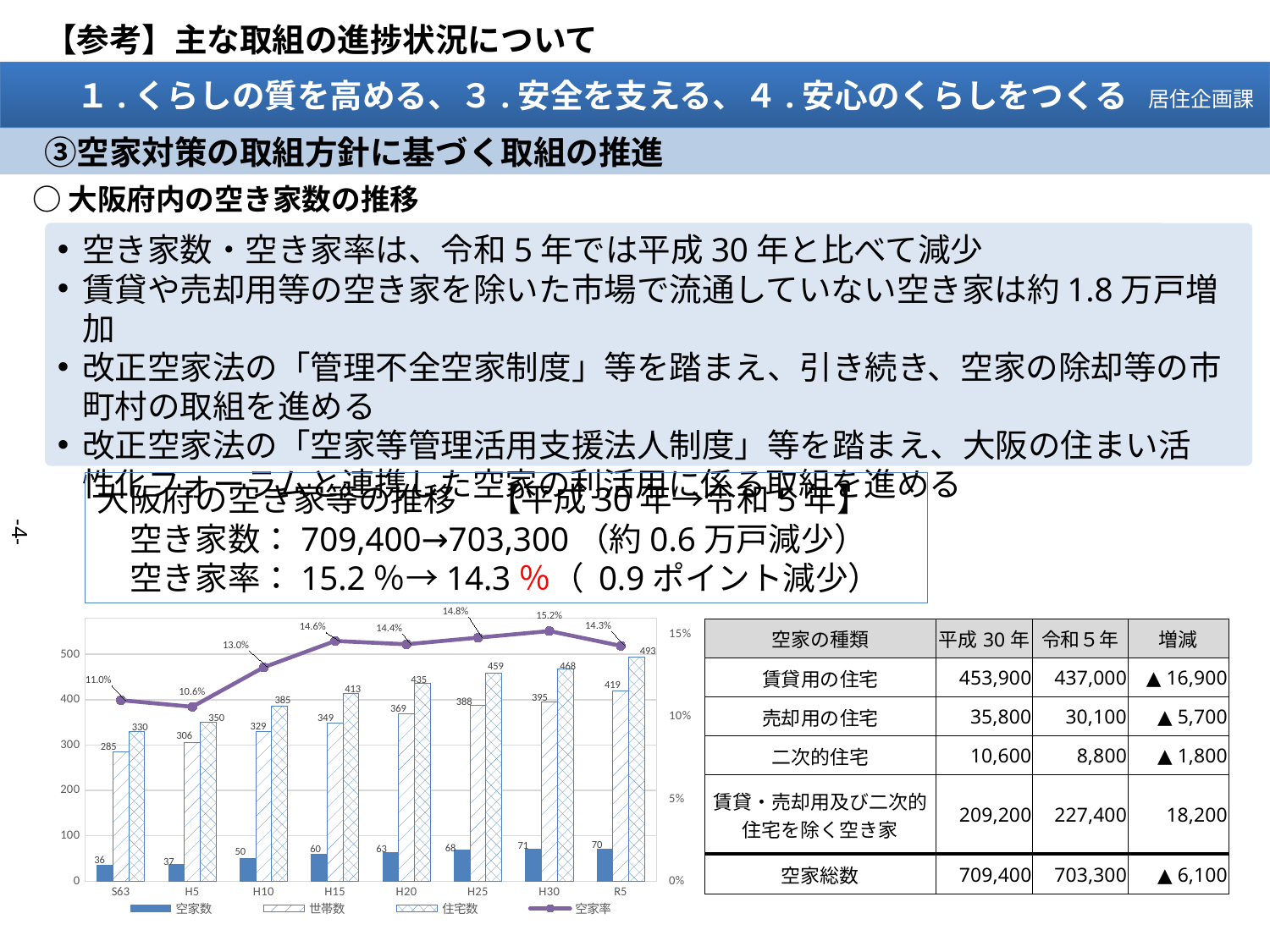
Which category has the lowest 空家率 in the chart? H5 What is the 空家率 for H30 in the chart? 15.2% Which is larger in the chart: 空家数 for H30 or 空家数 for R5? 空家数 for H30 How many series does the chart legend list? 4 Does 住宅数 rise or fall from S63 to R5 in the chart? rise Which series in the chart is drawn as a line rather than bars? 空家率 How many categories are shown on the x axis of the chart? 8 What is the value of 空家数 for H30 in the chart? 71 What is the value of 住宅数 for R5 in the chart? 493 What is the value of 世帯数 for S63 in the chart? 285 Which category has the highest 空家率 in the chart? H30 What is the difference between 住宅数 and 世帯数 for R5 in the chart? 74